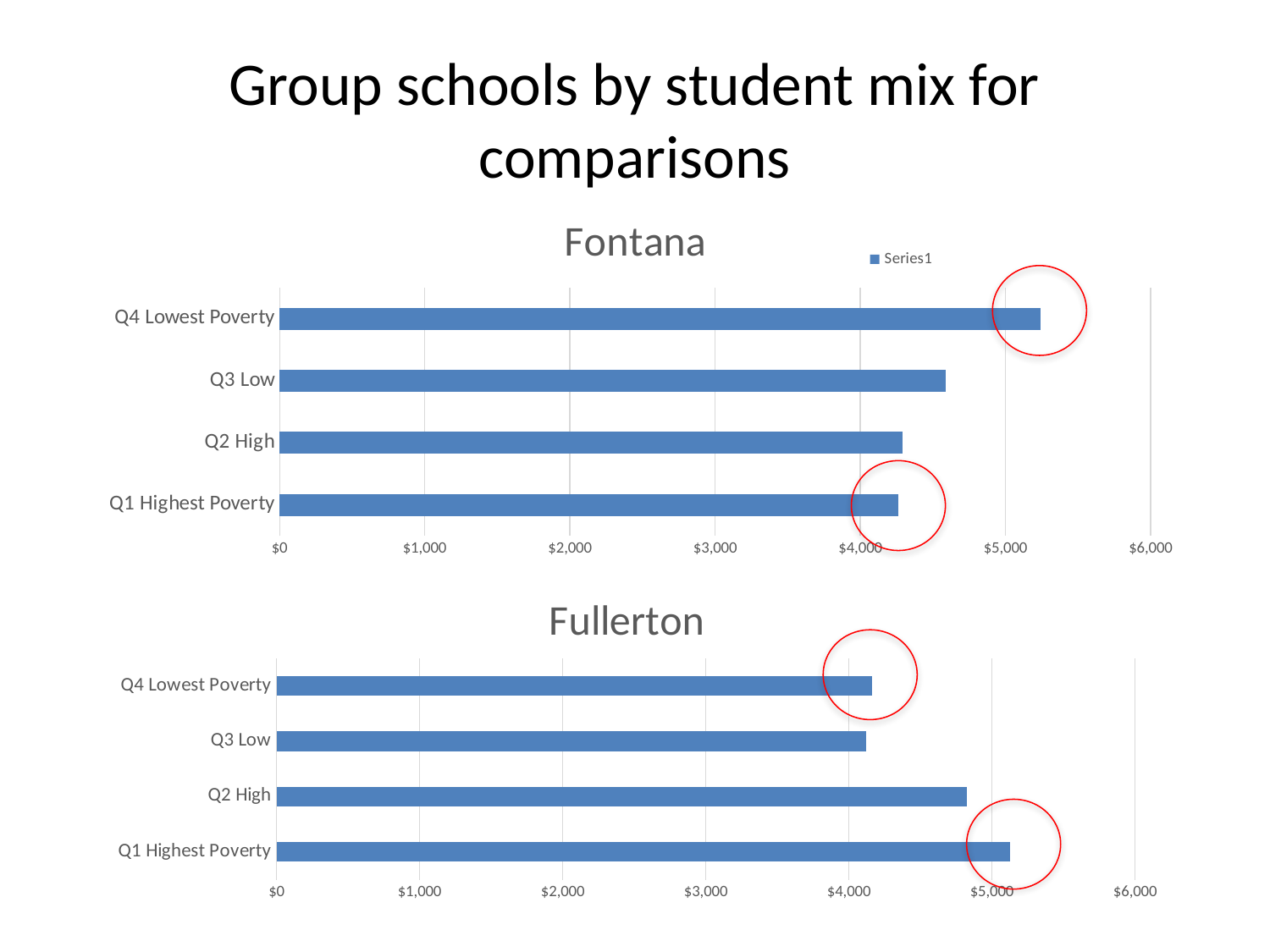
What is the legend entry shown on the Fontana chart? Series1 In the Fullerton chart, which is larger, the value for Q2 High or Q4 Lowest Poverty? Q2 High In the Fontana chart, is the value for Q4 Lowest Poverty greater or less than $5,000? greater In the Fontana chart, is the value for Q3 Low greater or less than $5,000? less What kind of chart is the Fontana chart? bar chart In the Fontana chart, which category has the highest value? Q4 Lowest Poverty In the Fullerton chart, which category has the highest value? Q1 Highest Poverty In the Fullerton chart, is the value for Q1 Highest Poverty greater or less than $5,000? greater In the Fullerton chart, which is larger, the value for Q1 Highest Poverty or Q3 Low? Q1 Highest Poverty How many categories are shown in the Fullerton chart? 4 In the Fontana chart, which is larger, the value for Q4 Lowest Poverty or Q3 Low? Q4 Lowest Poverty